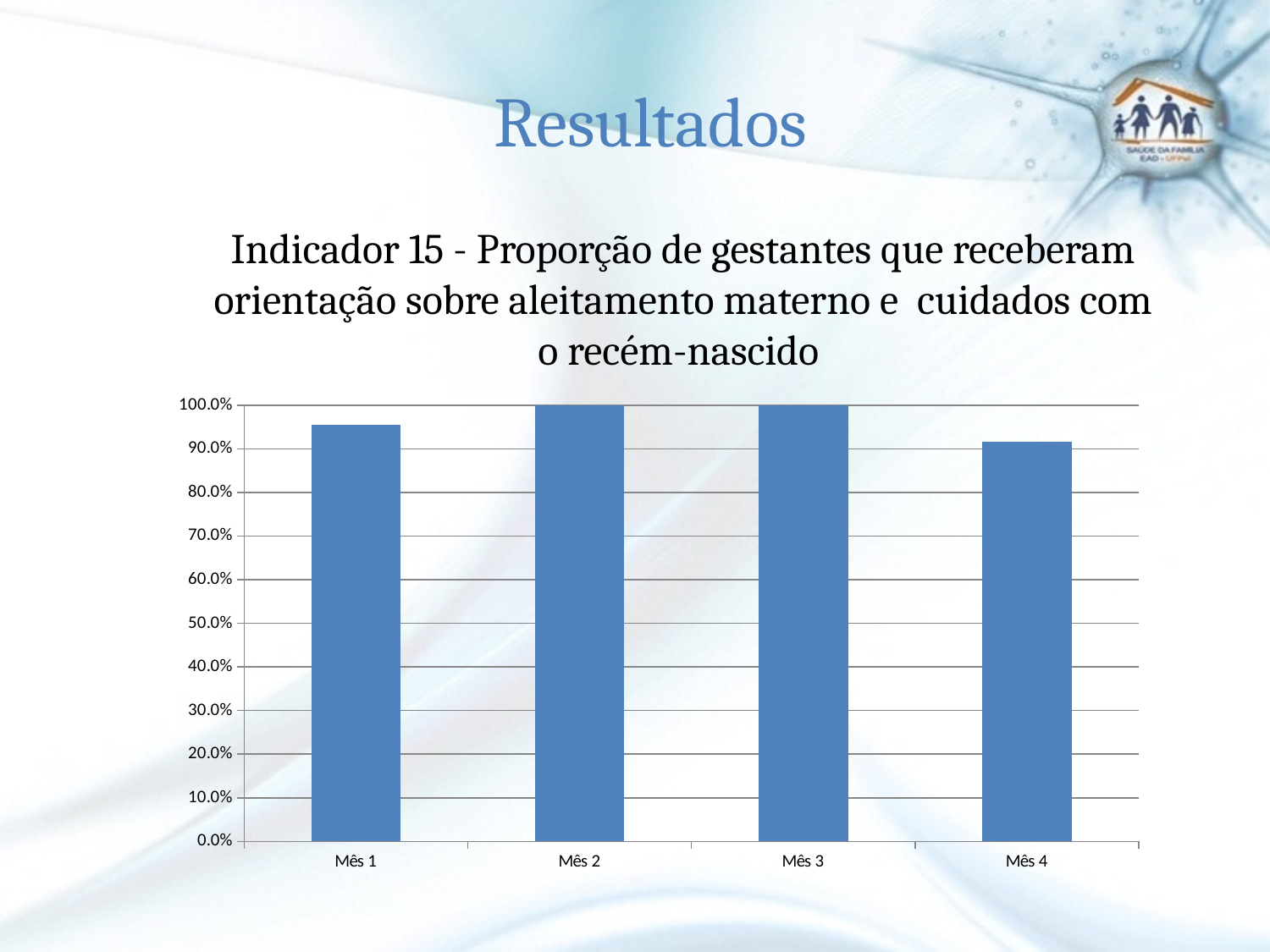
Does the value rise or fall from Mês 3 to Mês 4? fall What kind of chart is shown on the slide? bar chart Is the value for Mês 4 greater or less than 80.0%? greater How many categories (months) are shown on the x axis of the chart? 4 What is the value for Mês 2? 100.0% What is the number of the indicator named in the chart title? Indicador 15 What is the value for Mês 3? 100.0% Which is larger, the value for Mês 2 or the value for Mês 4? Mês 2 Which month has the lowest value in the chart? Mês 4 Is the value for Mês 4 greater or less than 100.0%? less Is the value for Mês 1 greater or less than 90.0%? greater Which is larger, the value for Mês 1 or the value for Mês 4? Mês 1